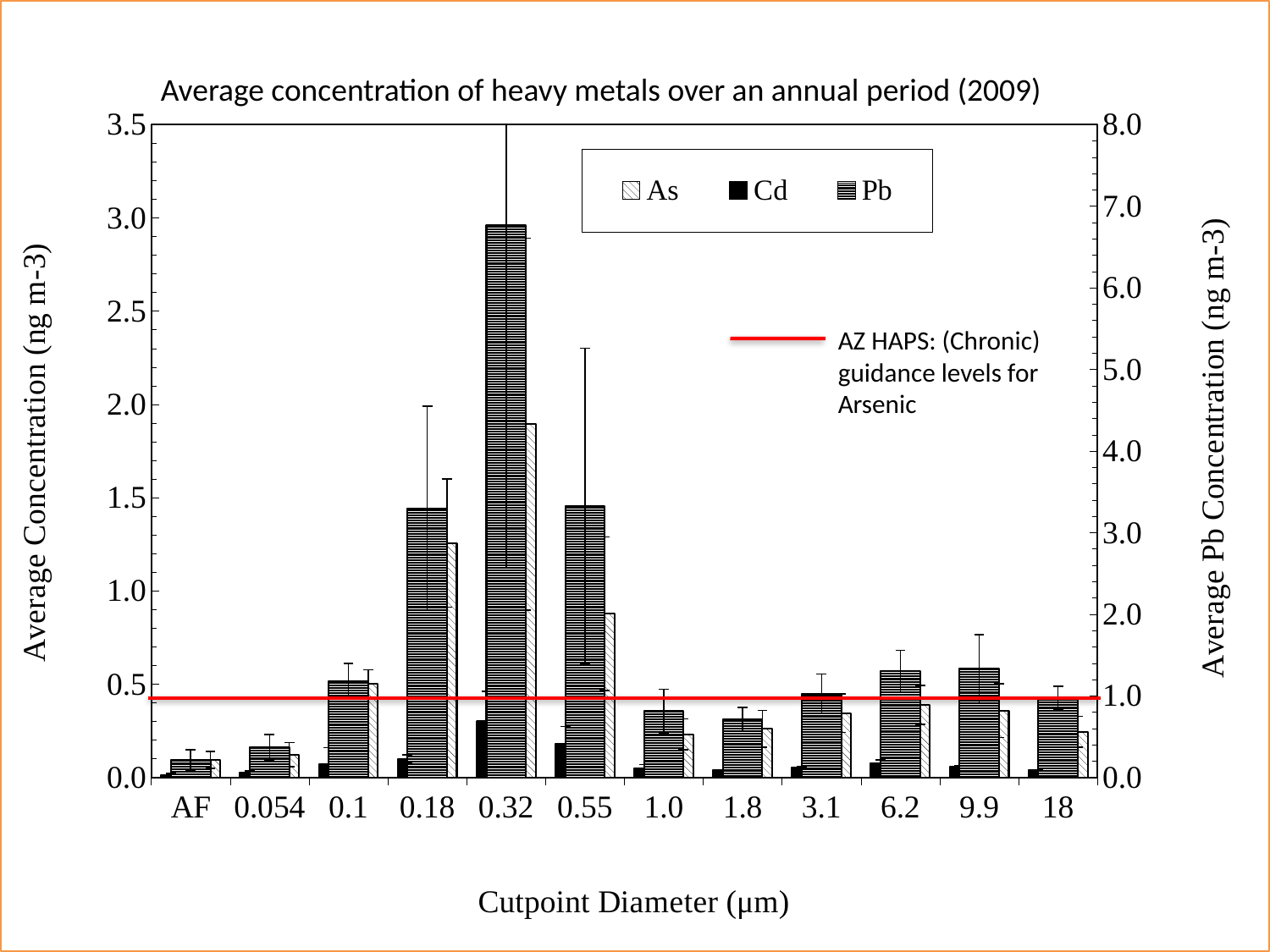
How many cutpoint diameter categories are shown on the x axis? 12 At which cutpoint diameter is the Pb concentration highest? 0.32 Is the As value at cutpoint diameter 0.32 greater or less than 1.5 on the left axis? greater What kind of chart is shown on the slide? bar chart Is the Pb value at cutpoint diameter 0.32 greater or less than 6.0 on the right axis? greater Is the Cd value at cutpoint diameter 0.32 greater or less than 0.5 on the left axis? less What does the red horizontal line on the chart represent? AZ HAPS: (Chronic) guidance levels for Arsenic How many series does the legend list? 3 Which is larger, the As value at cutpoint diameter 0.18 or the As value at cutpoint diameter 0.55? 0.18 What is the title of the chart? Average concentration of heavy metals over an annual period (2009) Do the As values rise or fall from cutpoint diameter 0.32 to 1.0? fall At which cutpoint diameter is the As concentration highest? 0.32